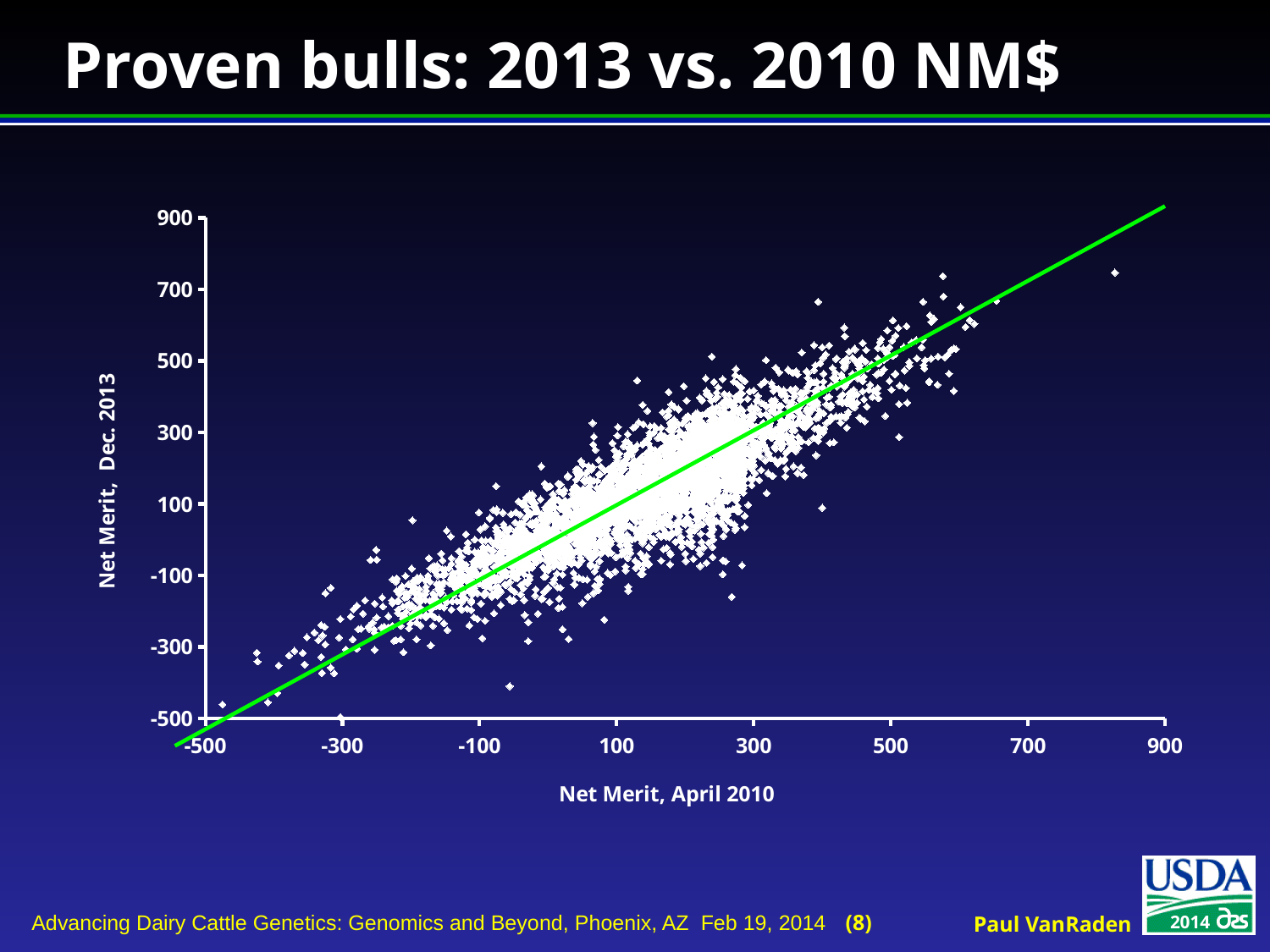
What is the label of the x axis? Net Merit, April 2010 What is the label of the y axis? Net Merit, Dec. 2013 As Net Merit, April 2010 increases along the x axis, do the Net Merit, Dec. 2013 values tend to rise or fall? Rise Does the green line on the chart slope upward or downward from left to right? Upward What kind of chart is shown on the slide? Scatter chart